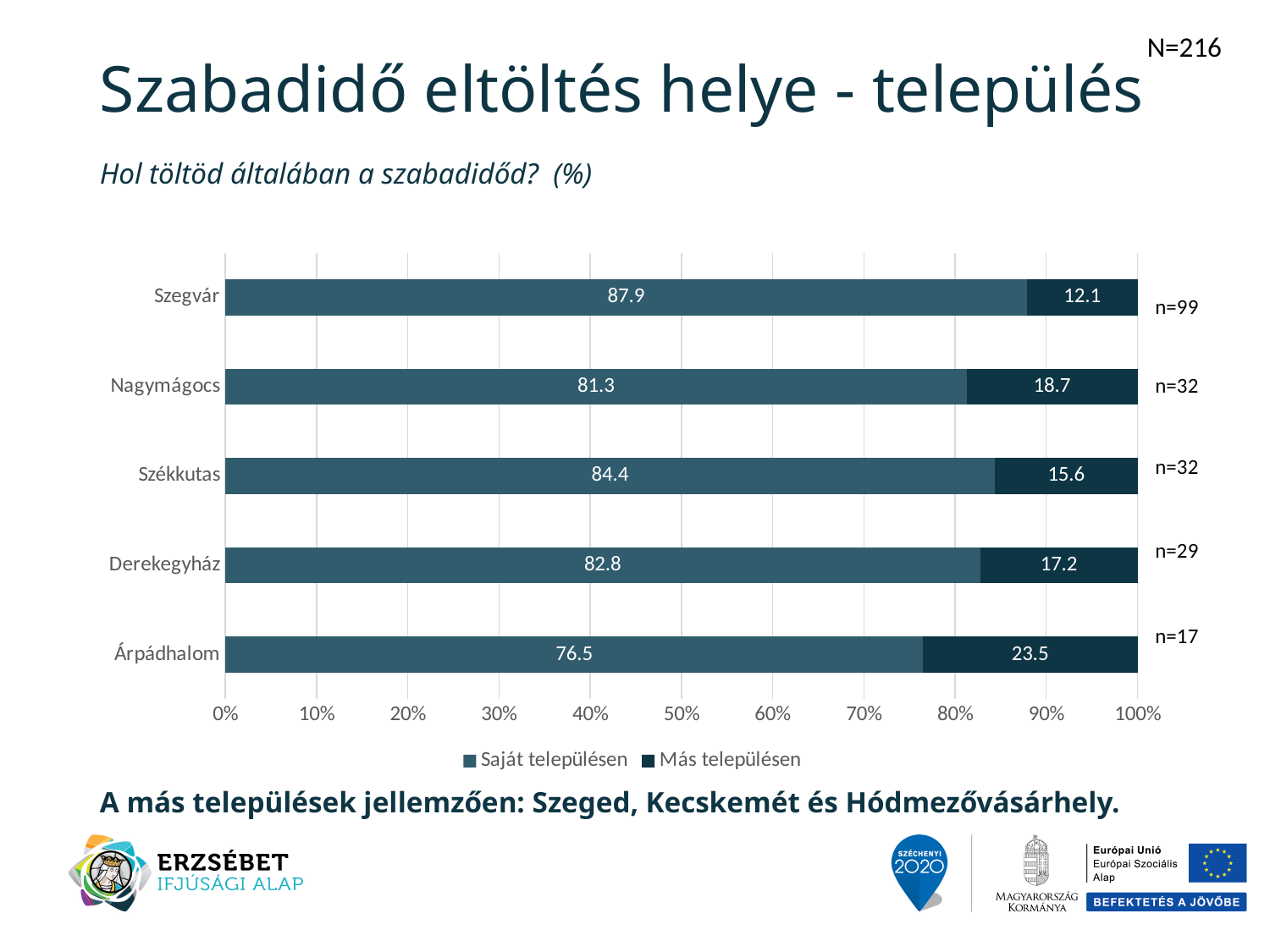
Which settlement has the lowest value for 'Saját településen'? Árpádhalom What is the value for 'Más településen' for Árpádhalom? 23.5 What is the sample size (n) shown for Szegvár? n=99 What is the total of the stacked bar for Székkutas? 100 How many settlements are shown on the chart? 5 How many series does the legend list? 2 Which is larger: the 'Más településen' value for Székkutas or for Derekegyház? Derekegyház What is the difference between the 'Saját településen' values for Szegvár and Árpádhalom? 11.4 What kind of chart is shown on the slide? Stacked bar chart What is the value for 'Saját településen' for Szegvár? 87.9 What is the value for 'Más településen' for Nagymágocs? 18.7 Which settlement has the highest value for 'Saját településen'? Szegvár